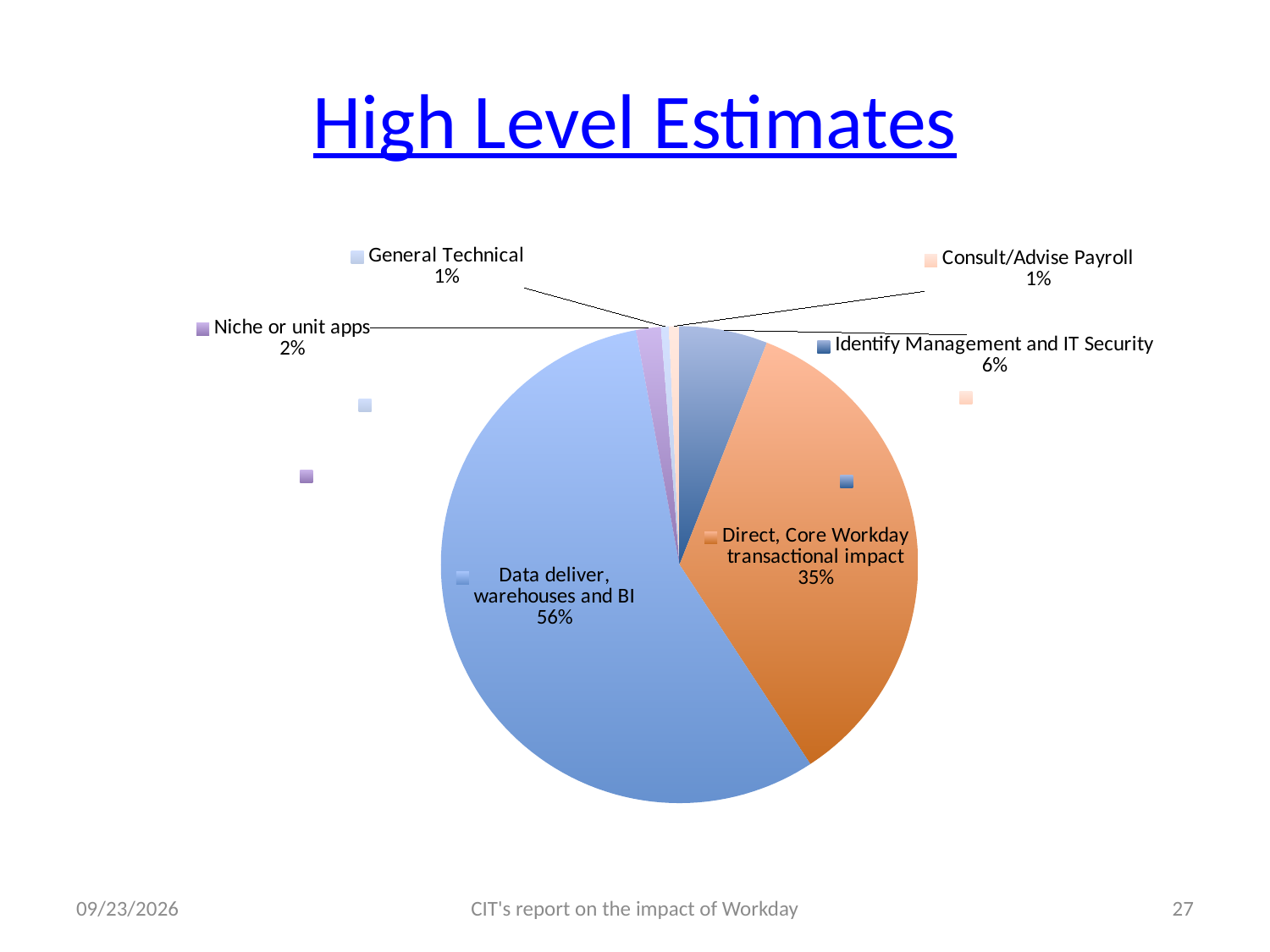
What share of the pie does "Direct, Core Workday transactional impact" represent? 35% What is the value shown for "General Technical"? 1% How many slices does the pie chart have? 6 What is the value shown for "Identify Management and IT Security"? 6% What is the title of the slide containing the chart? High Level Estimates What kind of chart is shown on the slide? pie chart What share of the pie does "Data deliver, warehouses and BI" represent? 56% What is the value shown for "Niche or unit apps"? 2% What is the difference in percentage points between "Identify Management and IT Security" and "Niche or unit apps"? 4 Which category has the largest slice of the pie? Data deliver, warehouses and BI Which is larger, "Direct, Core Workday transactional impact" or "Identify Management and IT Security"? Direct, Core Workday transactional impact What is the difference in percentage points between "Data deliver, warehouses and BI" and "Direct, Core Workday transactional impact"? 21